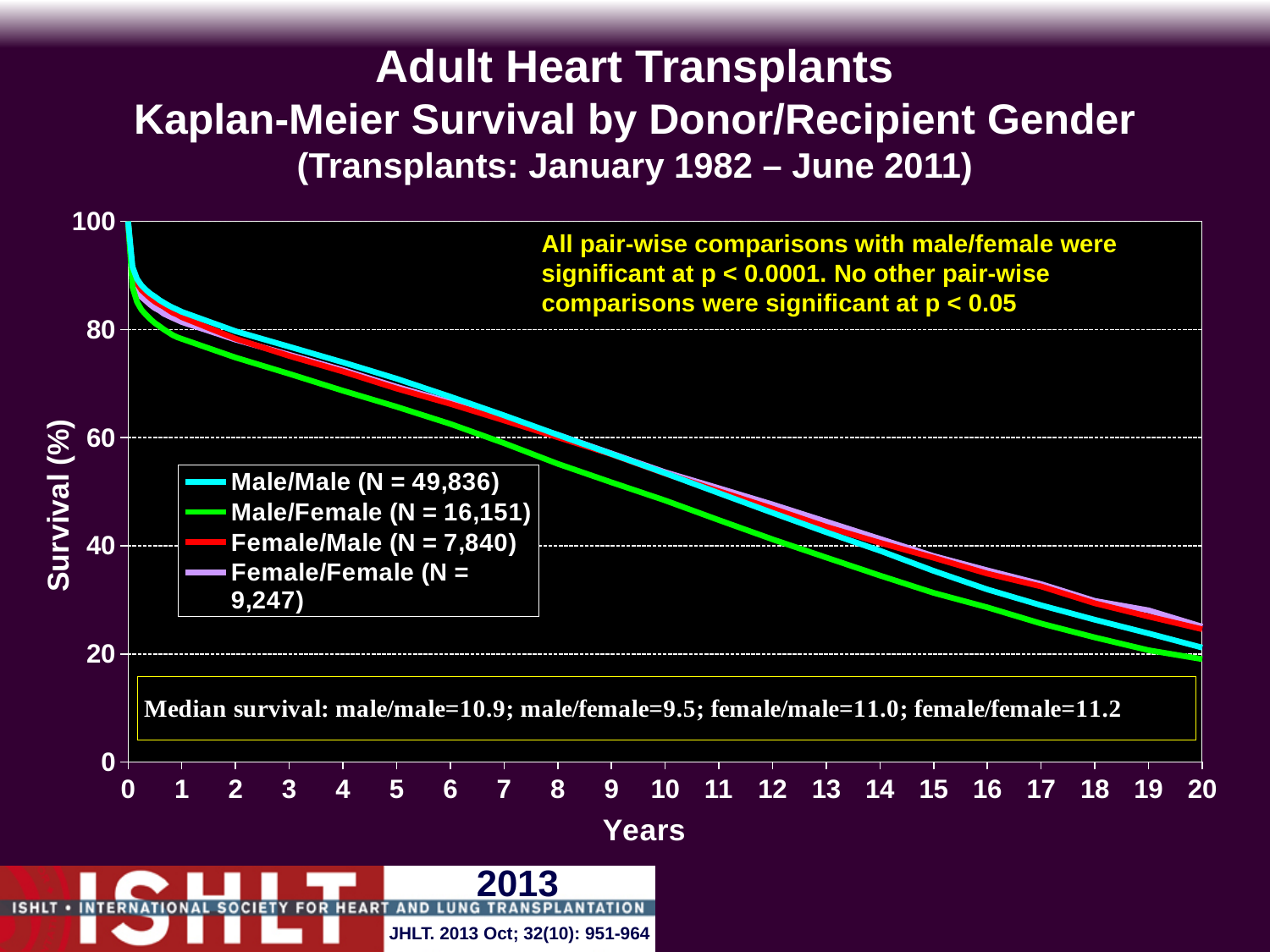
Which donor/recipient gender group has the largest N? Male/Male What is the N for the Female/Female group shown in the legend? 9,247 What is the N for the Male/Male group shown in the legend? 49,836 Which group has the highest median survival? female/female What kind of chart is shown on the slide? line chart Which series has the lowest survival curve across the years? Male/Female Do the survival curves rise or fall as years increase? fall Which donor/recipient gender group has the smallest N? Female/Male Is the survival for the Male/Female group at 10 years greater or less than 60? less What is the median survival for the male/female group? 9.5 How many series does the legend list? 4 What is the difference between the median survival of female/female and male/female? 1.7